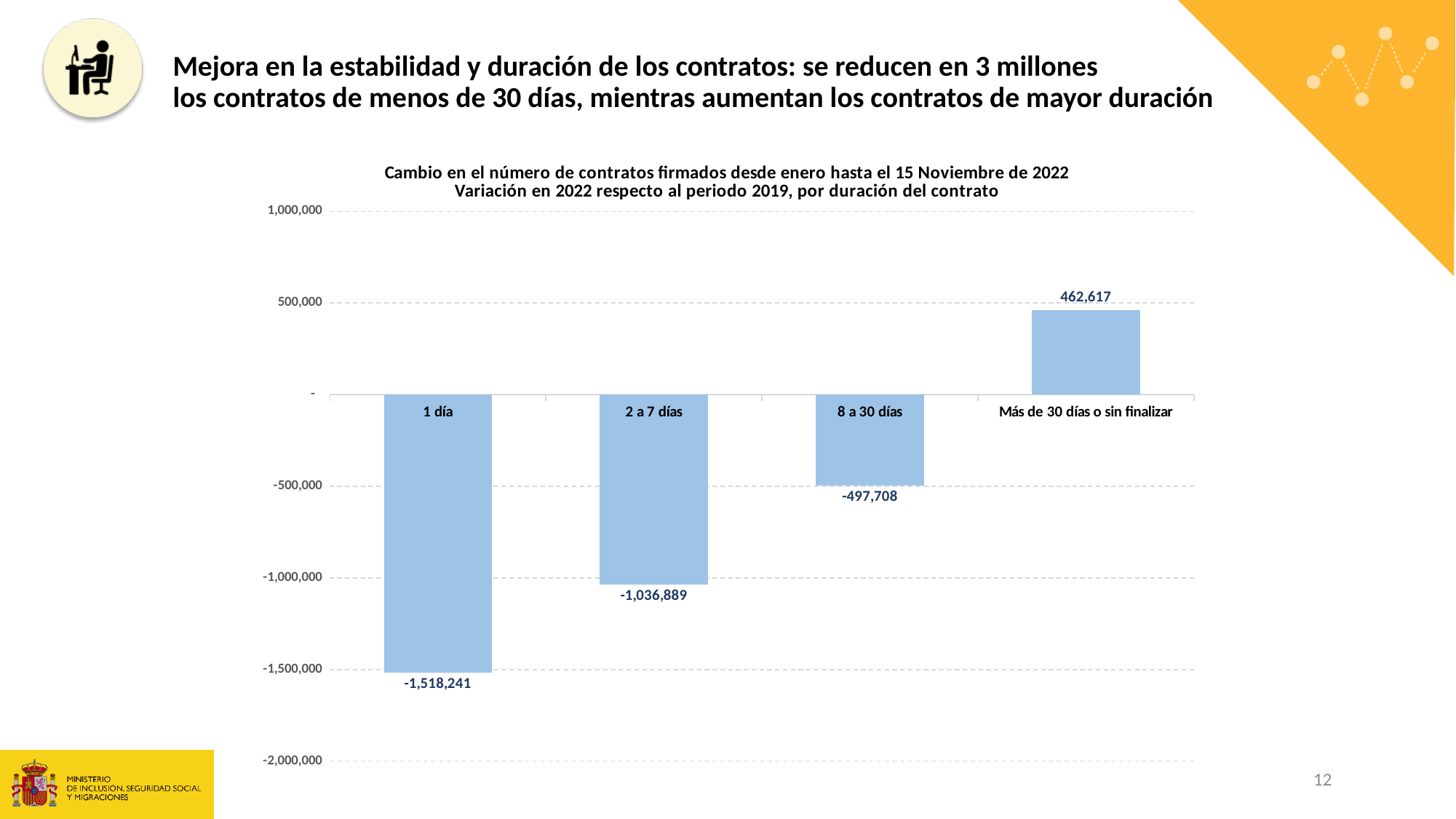
What is the difference between the values for "2 a 7 días" and "1 día"? 481,352 What kind of chart is shown on the slide? Bar chart What is the value for "8 a 30 días"? -497,708 What is the value for "2 a 7 días"? -1,036,889 What is the value for "1 día"? -1,518,241 What is the value for "Más de 30 días o sin finalizar"? 462,617 Which is larger, the value for "2 a 7 días" or the value for "8 a 30 días"? 8 a 30 días Which category has the lowest value? 1 día How many categories are shown in the chart? 4 Which category has the highest value? Más de 30 días o sin finalizar Do the values rise or fall moving from left to right along the x axis? Rise What is the difference between the values for "Más de 30 días o sin finalizar" and "8 a 30 días"? 960,325